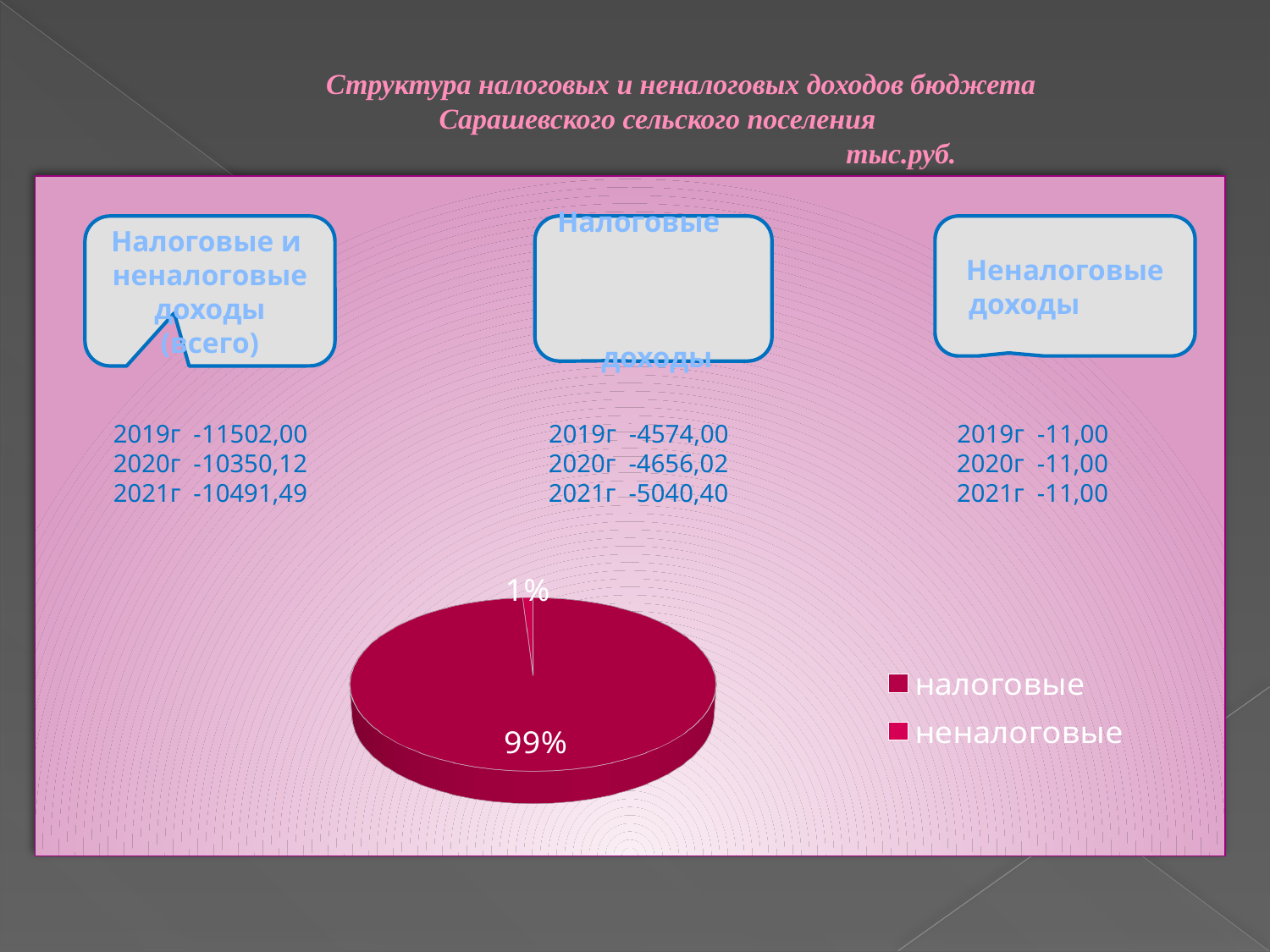
What colour is the налоговые slice of the pie chart? dark red (crimson) What do the two slices of the pie chart add up to? 100% What is the difference in percentage points between the налоговые and неналоговые slices? 98% What share of the pie does the налоговые slice represent? 99% What are the two entries listed in the pie chart's legend? налоговые, неналоговые How many slices does the pie chart have? 2 Which slice of the pie chart is the smallest? неналоговые How many entries does the legend of the pie chart list? 2 What share of the pie does the неналоговые slice represent? 1% Which is larger in the pie chart, налоговые or неналоговые? налоговые What kind of chart is shown on the slide? pie chart Which slice of the pie chart is the largest? налоговые